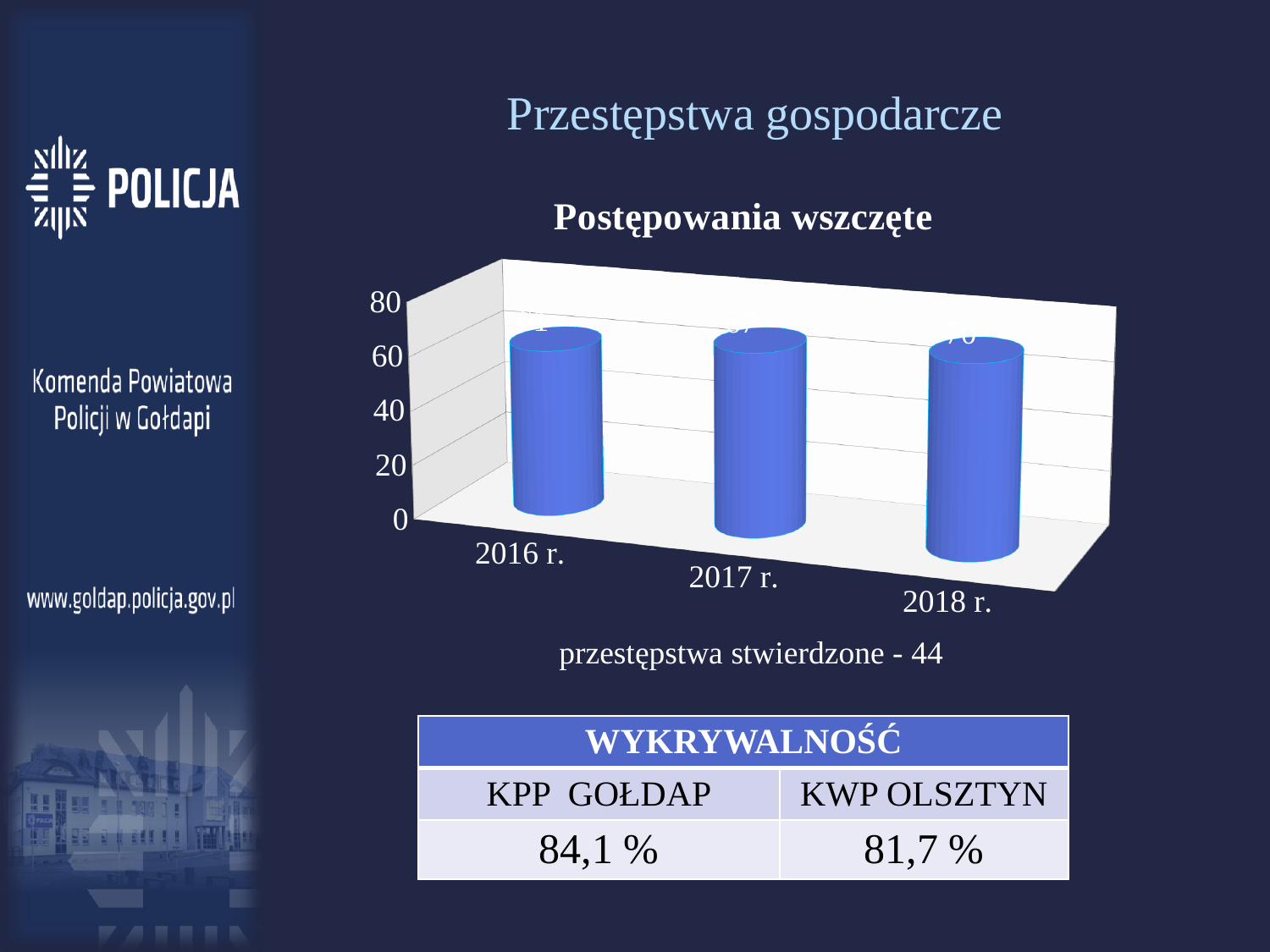
Is the value for 2017 r. in the "Postępowania wszczęte" chart greater or less than 80? less Is the value for 2016 r. in the "Postępowania wszczęte" chart greater or less than 80? less Is the value for 2016 r. in the "Postępowania wszczęte" chart greater or less than 40? greater How many categories (years) are plotted in the "Postępowania wszczęte" chart? 3 What kind of chart is shown under the heading "Postępowania wszczęte"? bar chart What is the title of the chart on the slide? Postępowania wszczęte What is the highest value shown on the vertical axis of the "Postępowania wszczęte" chart? 80 Which years are shown on the x axis of the "Postępowania wszczęte" chart? 2016 r., 2017 r., 2018 r.